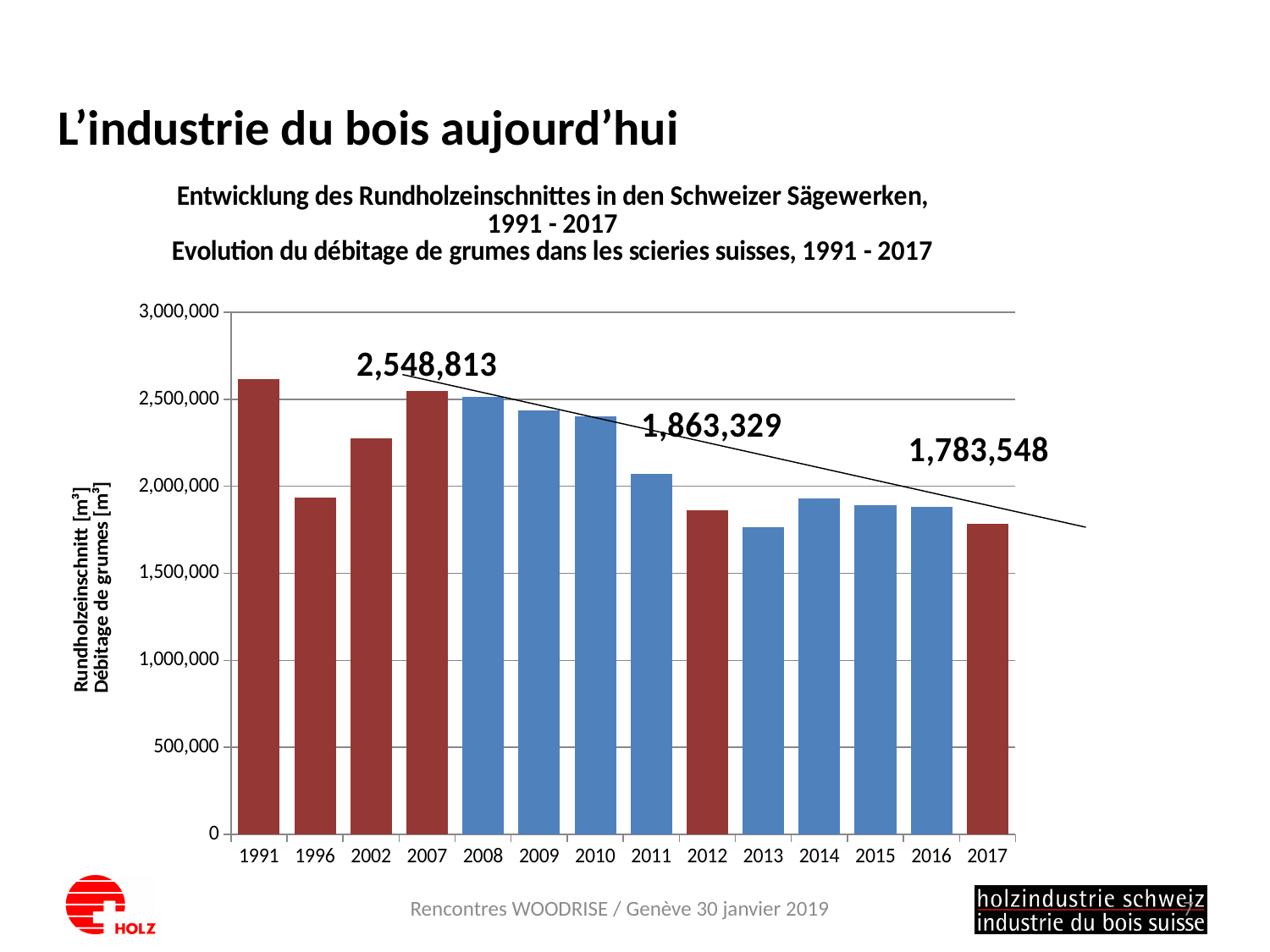
How many years are shown on the x axis? 14 What value is labelled for 2017? 1,783,548 Which year has the highest bar? 1991 Do the values generally rise or fall from 1991 to 2017? fall What is the difference between the labelled values for 2007 and 2017? 765,265 What value is labelled for 2012? 1,863,329 What kind of chart is shown? bar chart What is the difference between the labelled values for 2012 and 2017? 79,781 Is the value for 2013 greater or less than 2,000,000? less What value is labelled for 2007? 2,548,813 Which is larger, the value for 2008 or the value for 2011? 2008 Is the value for 1991 greater or less than 2,500,000? greater